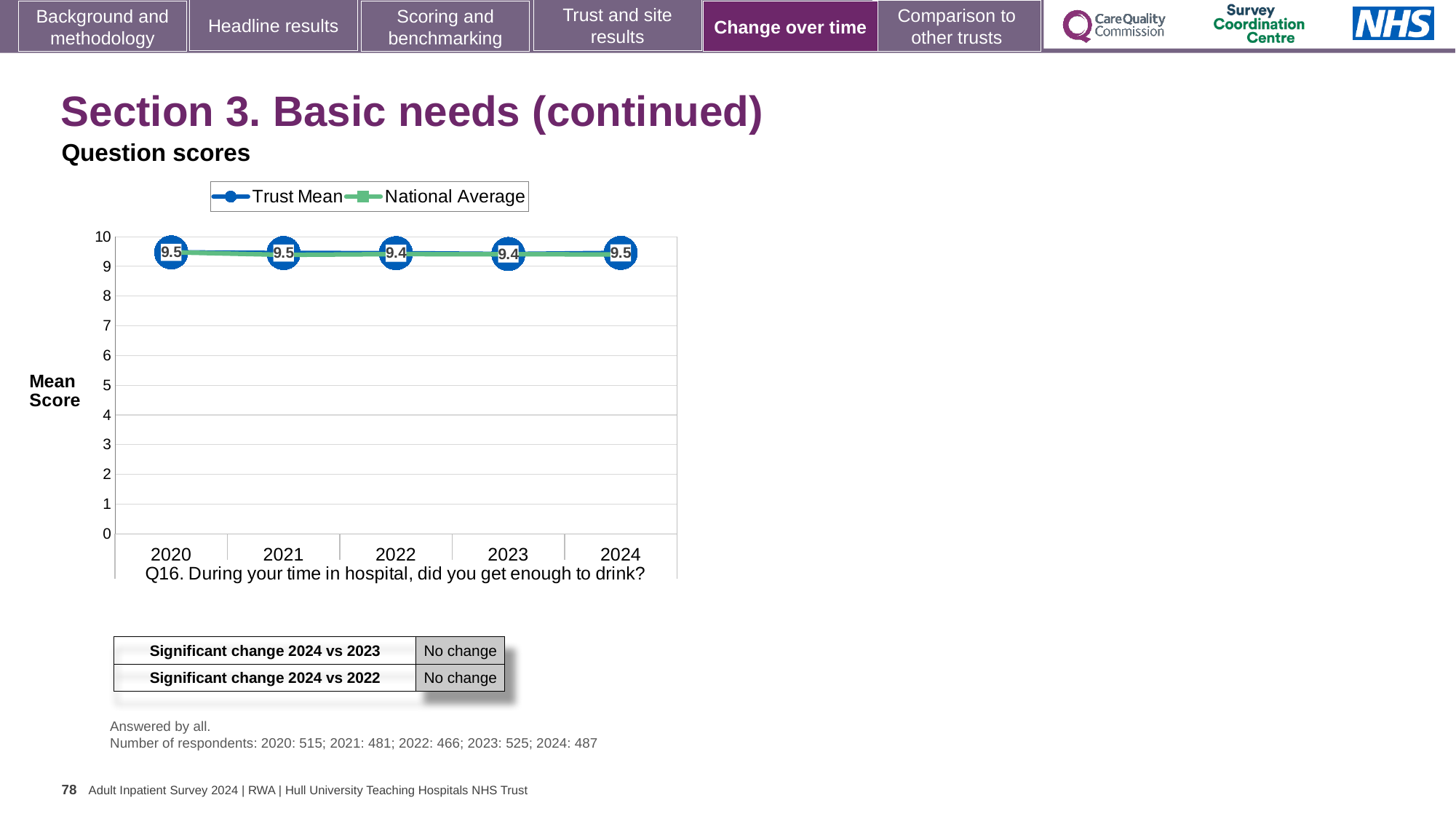
Is the Trust Mean score for 2021 larger or smaller than the Trust Mean score for 2023? larger How many years are shown on the x axis of the chart? 5 What is the label of the y axis of the chart? Mean Score Which series is shown in blue in the chart legend? Trust Mean What is the Trust Mean score for 2024? 9.5 Is the Trust Mean score for 2024 greater or less than 9? greater What is the Trust Mean score for 2023? 9.4 How many series does the chart legend list? 2 What kind of chart is shown on the slide? line chart What is the difference between the Trust Mean score in 2021 and in 2022? 0.1 What is the Trust Mean score for 2020? 9.5 What is the Trust Mean score for 2022? 9.4